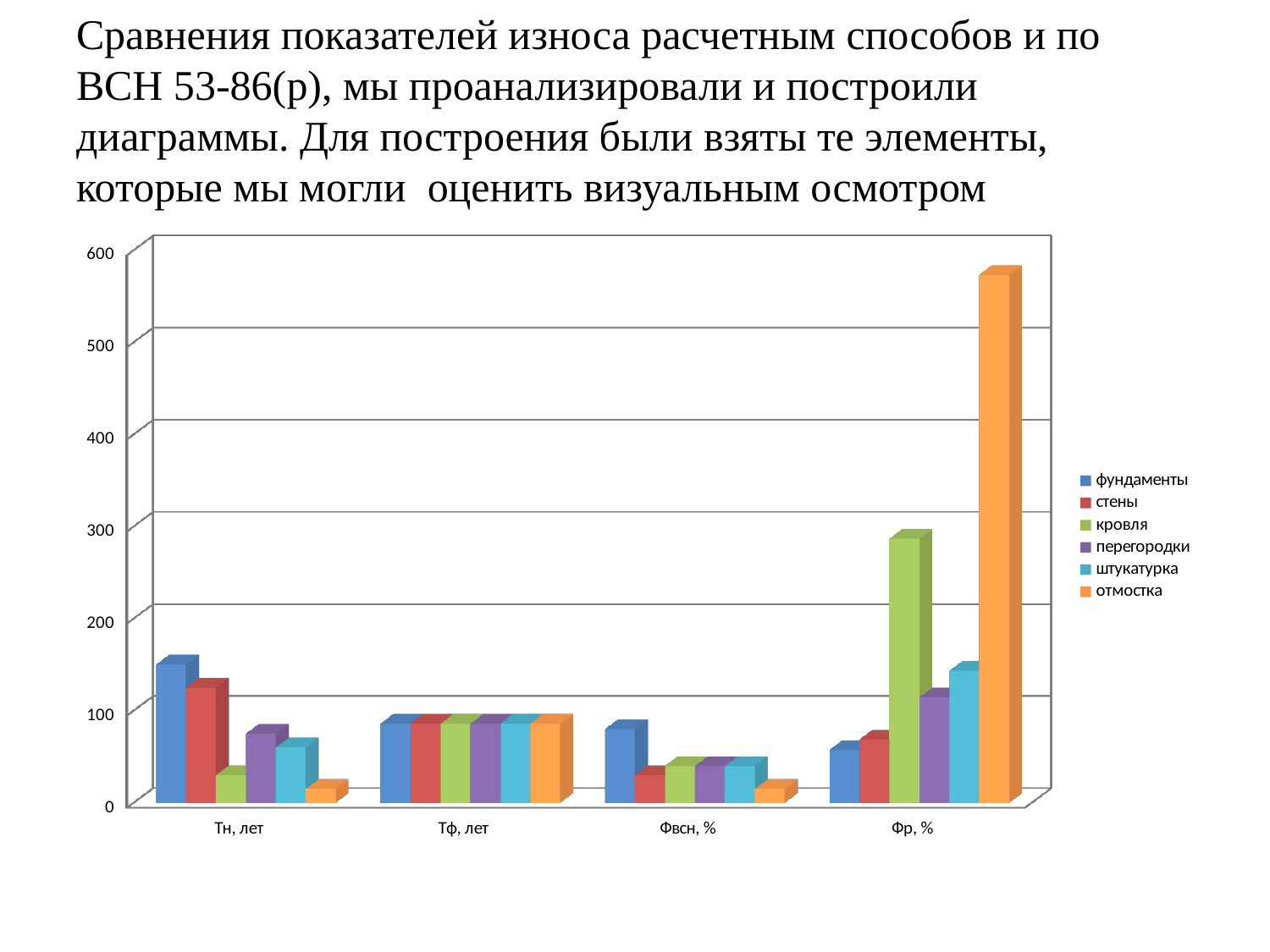
Is the value for кровля in the Тн, лет category greater or less than 100? less In the Фвсн, % category, which is larger: the value for фундаменты or the value for стены? фундаменты Is the value for фундаменты in the Тн, лет category greater or less than 100? greater Which series has the shortest bar in the Тн, лет category? отмостка Is the value for отмостка in the Фр, % category greater or less than 500? greater Which series has the tallest bar in the Фр, % category? отмостка Which series is shown in orange in the chart's legend? отмостка How many categories are shown along the x axis of the chart? 4 What kind of chart is shown on the slide? bar chart How many series does the chart's legend list? 6 In the Фр, % category, which is larger: the value for кровля or the value for перегородки? кровля